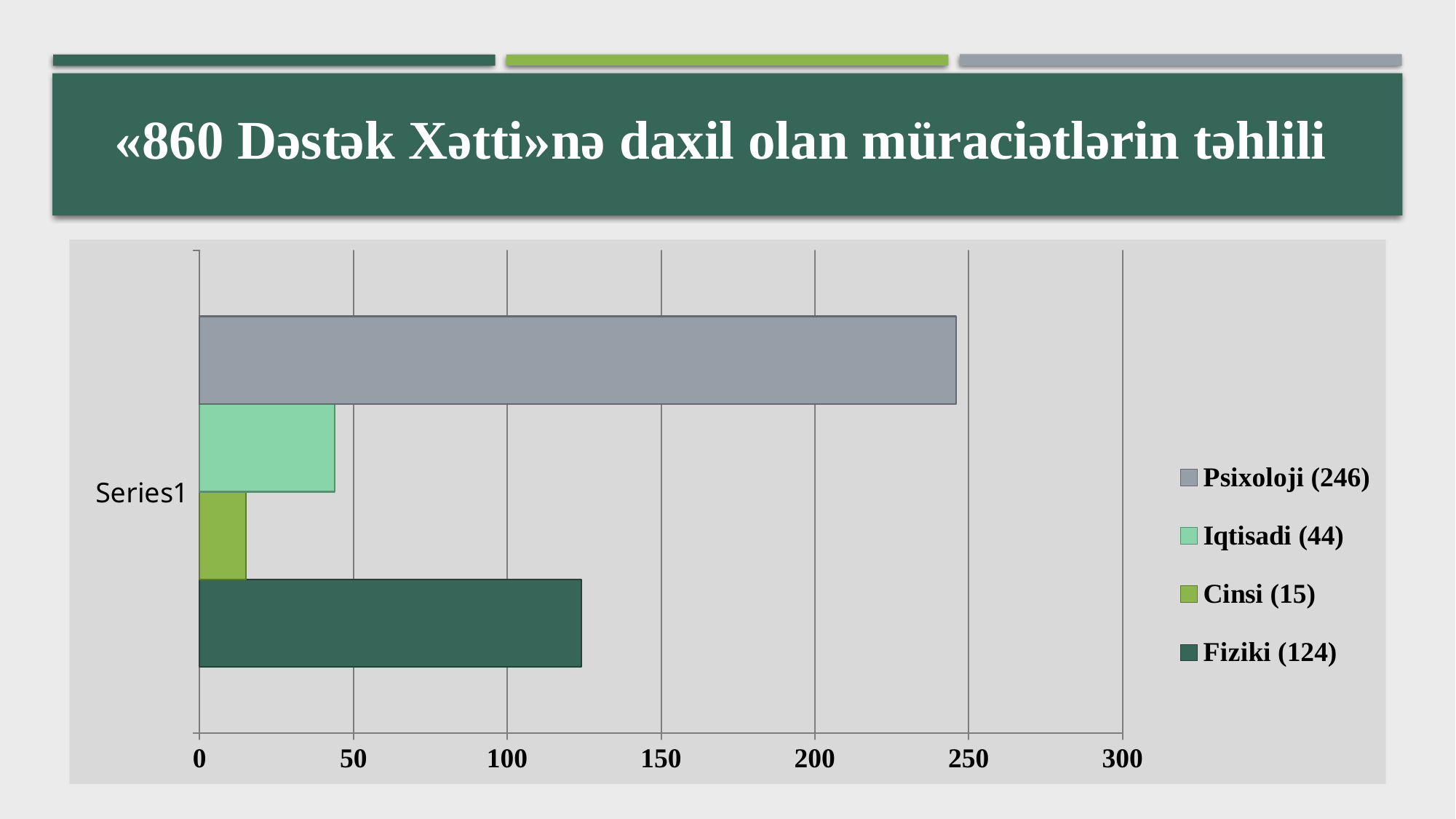
What is the difference between the values for Psixoloji and Fiziki? 122 Which series has the highest value? Psixoloji Which series has the lowest value? Cinsi Which is larger, the value for Iqtisadi or the value for Fiziki? Fiziki Is the value for Fiziki greater or less than 100? greater What kind of chart is shown on the slide? bar chart What is the value for Cinsi? 15 What is the value for Fiziki? 124 What is the title of the slide? «860 Dəstək Xətti»nə daxil olan müraciətlərin təhlili What is the value for Iqtisadi? 44 What is the value for Psixoloji? 246 How many series does the legend list? 4